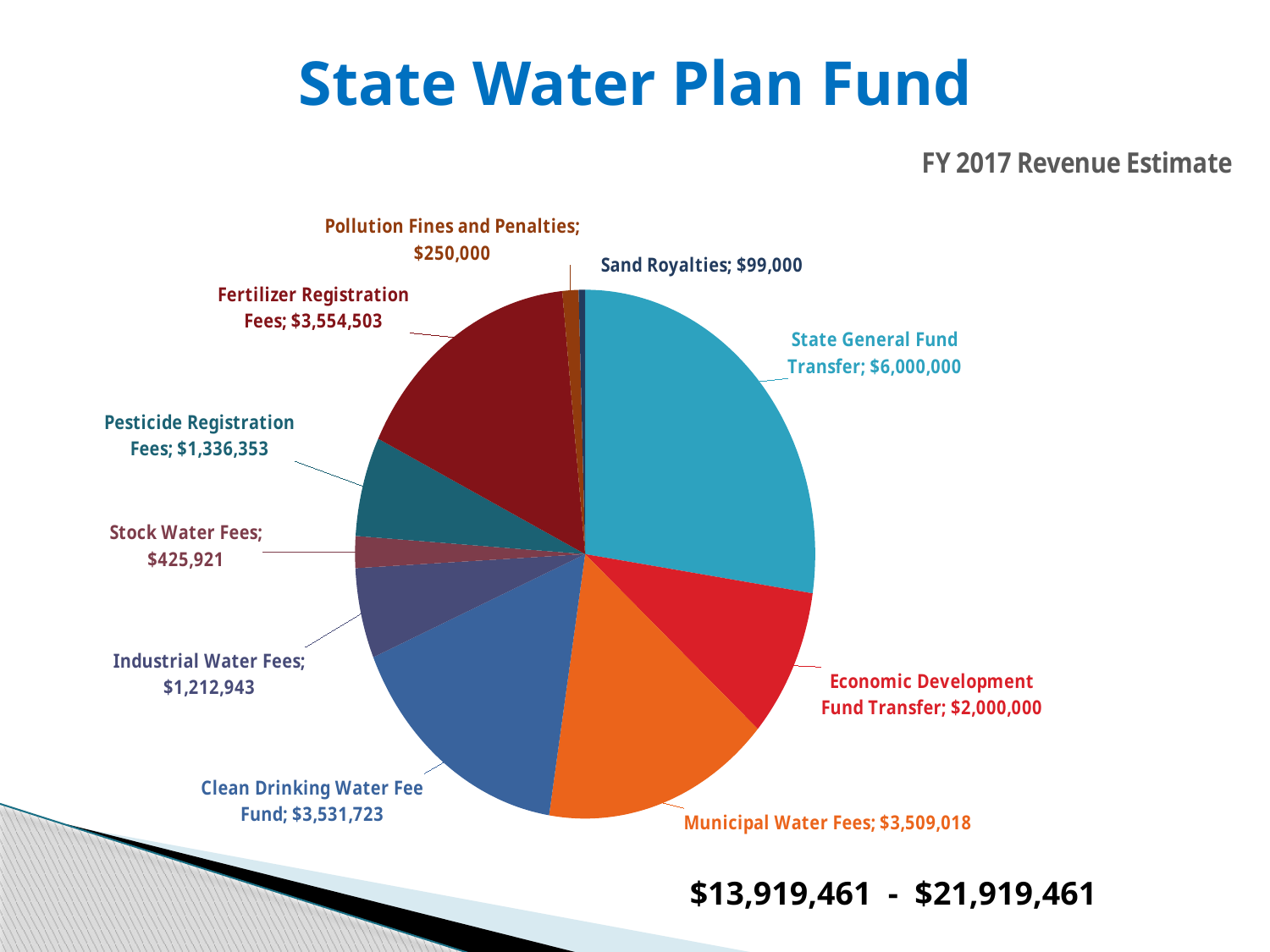
What is the difference between Fertilizer Registration Fees and Clean Drinking Water Fee Fund? $22,780 Which is larger, Industrial Water Fees or Stock Water Fees? Industrial Water Fees What is the subtitle shown above the chart on the right? FY 2017 Revenue Estimate What is the value for Municipal Water Fees? $3,509,018 What is the value for Pesticide Registration Fees? $1,336,353 What kind of chart is shown on the slide? Pie chart What is the value for State General Fund Transfer? $6,000,000 What is the difference between State General Fund Transfer and Economic Development Fund Transfer? $4,000,000 Which category has the smallest slice of the pie? Sand Royalties What is the value for Sand Royalties? $99,000 Which category has the largest slice of the pie? State General Fund Transfer How many slices does the pie chart have? 10